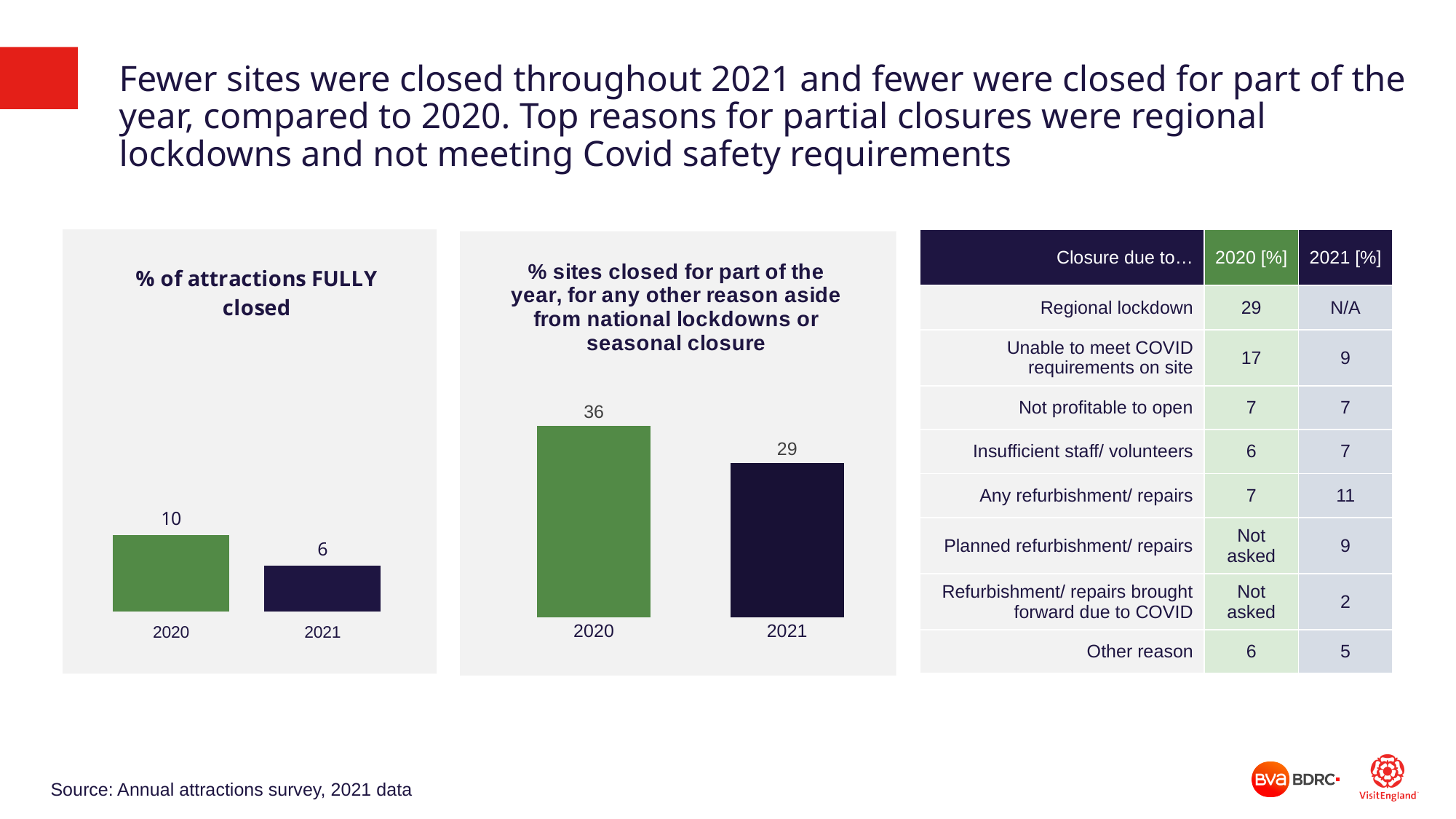
What kind of chart is the '% of attractions FULLY closed' chart? bar chart In the '% of attractions FULLY closed' chart, what is the value for 2021? 6 In the '% sites closed for part of the year' chart, what is the difference between the 2020 and 2021 values? 7 In the '% sites closed for part of the year' chart, what is the value for 2021? 29 In the '% of attractions FULLY closed' chart, what colour is the 2020 bar? green In the '% of attractions FULLY closed' chart, which year has the higher value? 2020 How many bars are shown in the '% sites closed for part of the year' chart? 2 In the '% sites closed for part of the year' chart, which year has the lower value? 2021 In the '% of attractions FULLY closed' chart, what is the difference between the 2020 and 2021 values? 4 In the '% sites closed for part of the year' chart, what is the value for 2020? 36 In the '% sites closed for part of the year' chart, do the values rise or fall from 2020 to 2021? fall In the '% of attractions FULLY closed' chart, what is the value for 2020? 10